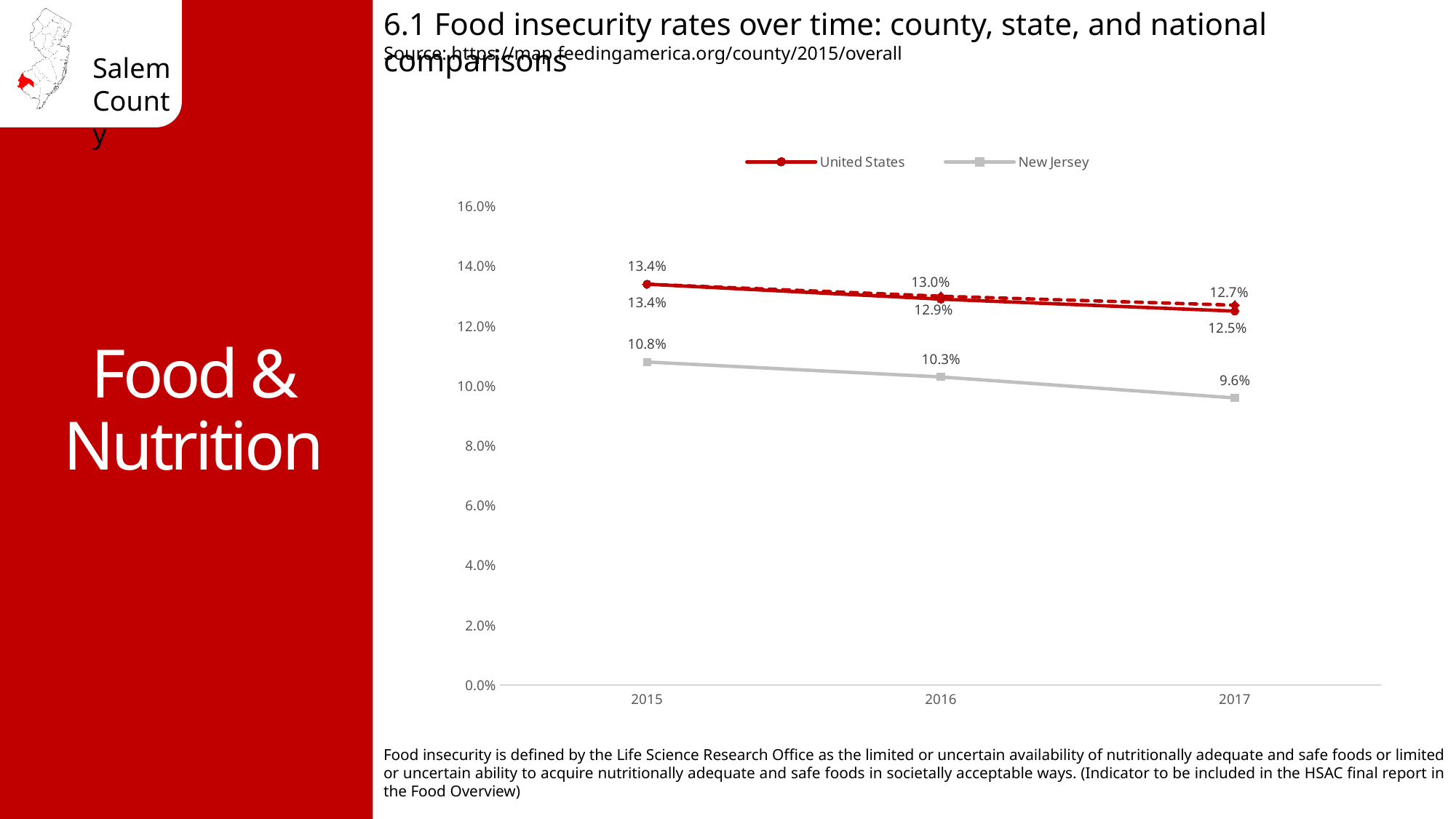
What was the food insecurity rate for the United States in 2015? 13.4% How many series does the chart legend list? 2 Does the New Jersey food insecurity rate rise or fall from 2015 to 2017? fall How many years are shown on the x axis of the chart? 3 What was the food insecurity rate for New Jersey in 2017? 9.6% In which year was the New Jersey food insecurity rate lowest? 2017 In 2017, which had the higher food insecurity rate, the United States or New Jersey? United States What was the food insecurity rate for New Jersey in 2015? 10.8% What was the food insecurity rate for New Jersey in 2016? 10.3% What kind of chart is shown on the slide? line chart What was the food insecurity rate for the United States in 2017? 12.5% By how many percentage points did the New Jersey food insecurity rate fall from 2015 to 2017? 1.2 percentage points